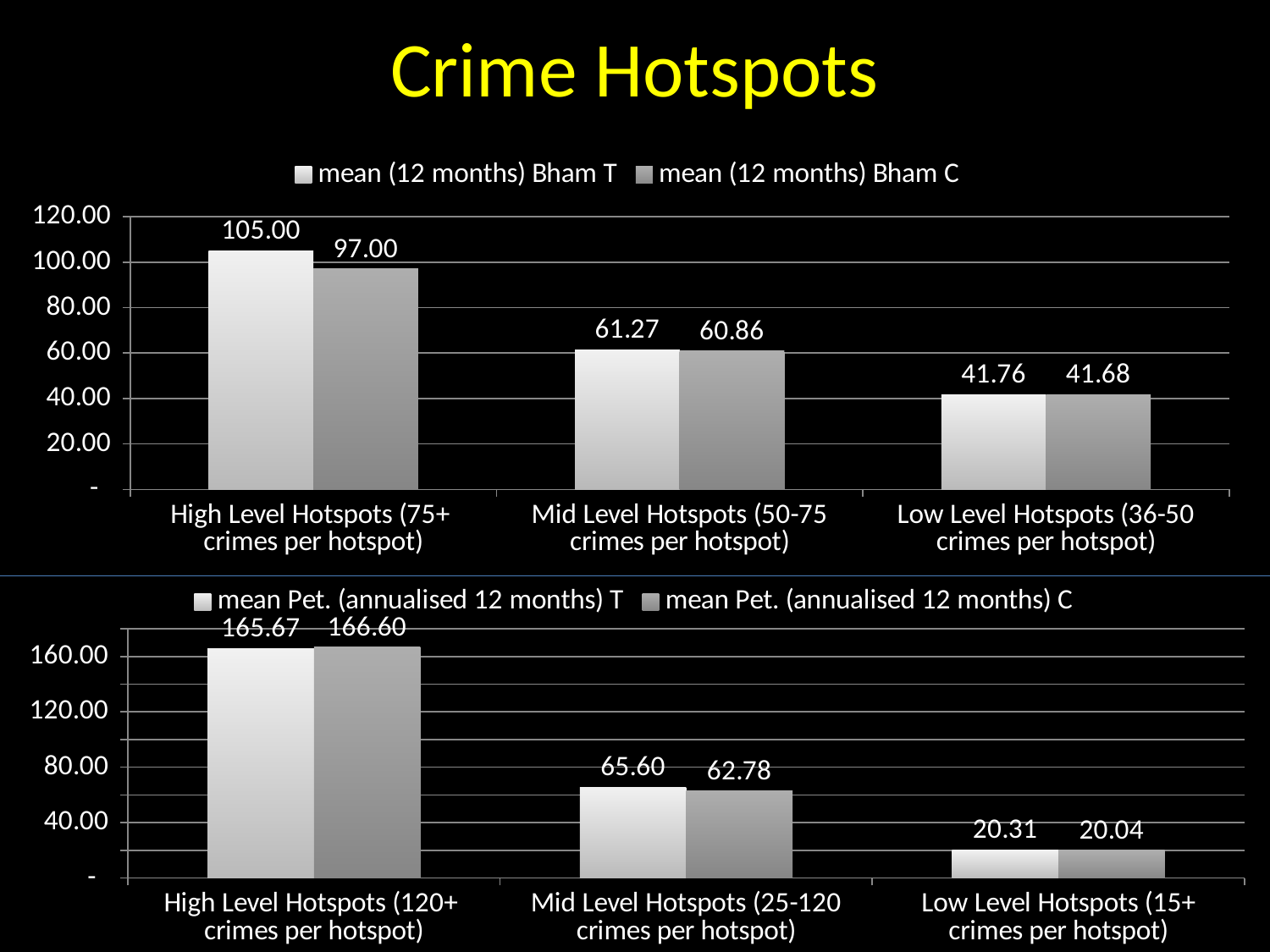
In the bottom chart, do the values for mean Pet. (annualised 12 months) T rise or fall from left to right along the x axis? Fall In the bottom chart, what is the value of mean Pet. (annualised 12 months) T for Low Level Hotspots (15+ crimes per hotspot)? 20.31 In the bottom chart, which category has the highest value for mean Pet. (annualised 12 months) T? High Level Hotspots (120+ crimes per hotspot) In the top chart, what is the value of mean (12 months) Bham C for Mid Level Hotspots (50-75 crimes per hotspot)? 60.86 In the top chart, which category has the lowest value for mean (12 months) Bham T? Low Level Hotspots (36-50 crimes per hotspot) In the bottom chart, what is the difference between the T and C values for Mid Level Hotspots (25-120 crimes per hotspot)? 2.82 In the bottom chart, what is the value of mean Pet. (annualised 12 months) C for High Level Hotspots (120+ crimes per hotspot)? 166.60 In the top chart, how many series does the legend list? 2 What kind of chart is the top chart? Bar chart In the top chart, what is the difference between the Bham T and Bham C values for High Level Hotspots (75+ crimes per hotspot)? 8.00 In the top chart, what is the value of mean (12 months) Bham T for High Level Hotspots (75+ crimes per hotspot)? 105.00 In the bottom chart, how many categories are shown on the x axis? 3